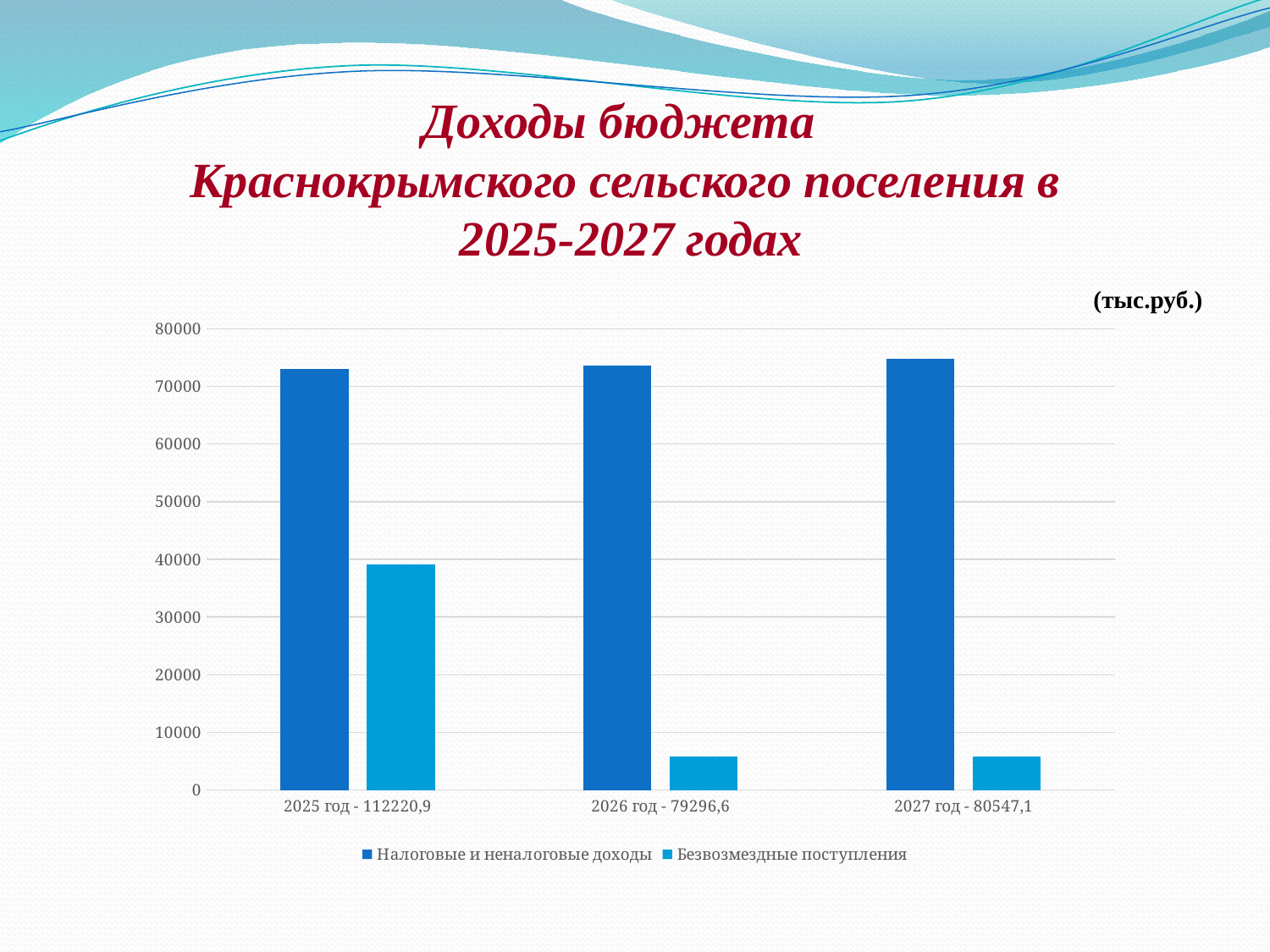
Is the value for Безвозмездные поступления in 2026 год greater or less than 10000? less In which year is the value for Безвозмездные поступления highest? 2025 год What kind of chart is shown on the slide? Bar chart What total is printed in the category label for 2025 год? 112220,9 Which is larger in 2025 год: Налоговые и неналоговые доходы or Безвозмездные поступления? Налоговые и неналоговые доходы In what units are the chart values given, according to the label above the chart? тыс.руб. How many series does the legend list? 2 How many year categories are shown on the x axis? 3 Do the values for Безвозмездные поступления rise or fall from 2025 год to 2026 год? fall Is the value for Налоговые и неналоговые доходы in 2025 год greater or less than 70000? greater What total is printed in the category label for 2026 год? 79296,6 What total is printed in the category label for 2027 год? 80547,1